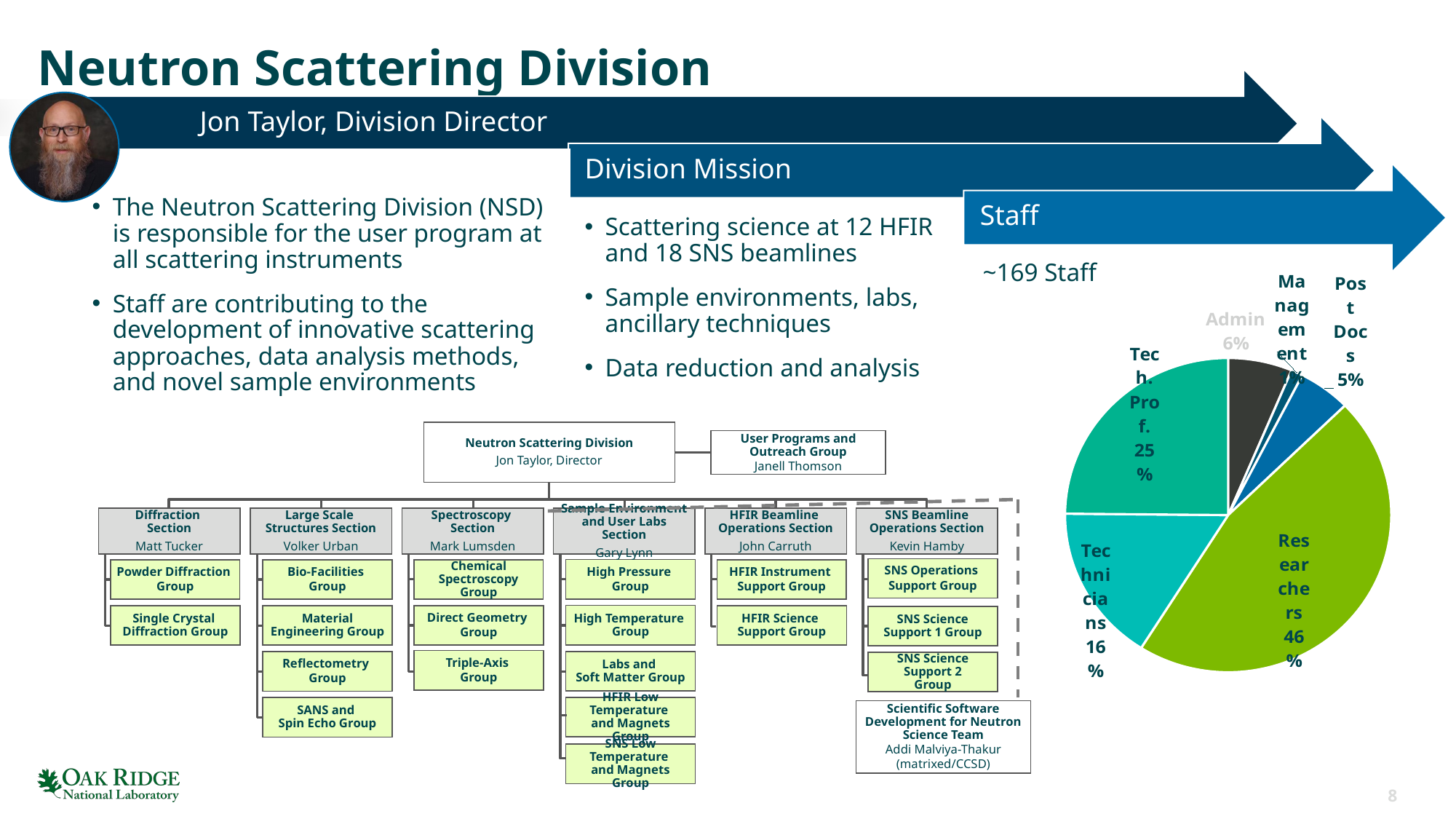
What kind of chart is shown under the Staff heading? pie chart In the Staff pie chart, what share of staff are Post Docs? 5% In the Staff pie chart, what share of staff are Technicians? 16% Which category has the largest slice in the Staff pie chart? Researchers In the Staff pie chart, how many percentage points larger is the Researchers share than the Tech. Prof. share? 21 percentage points In the Staff pie chart, what is the difference between the Tech. Prof. share and the Technicians share? 9 percentage points In the Staff pie chart, what share of staff are Tech. Prof.? 25% In the Staff pie chart, what share of staff are Admin? 6% Which category has the smallest slice in the Staff pie chart? Management How many slices does the Staff pie chart have? 6 In the Staff pie chart, what share of staff are Researchers? 46% In the Staff pie chart, which is larger: the Technicians share or the Admin share? Technicians